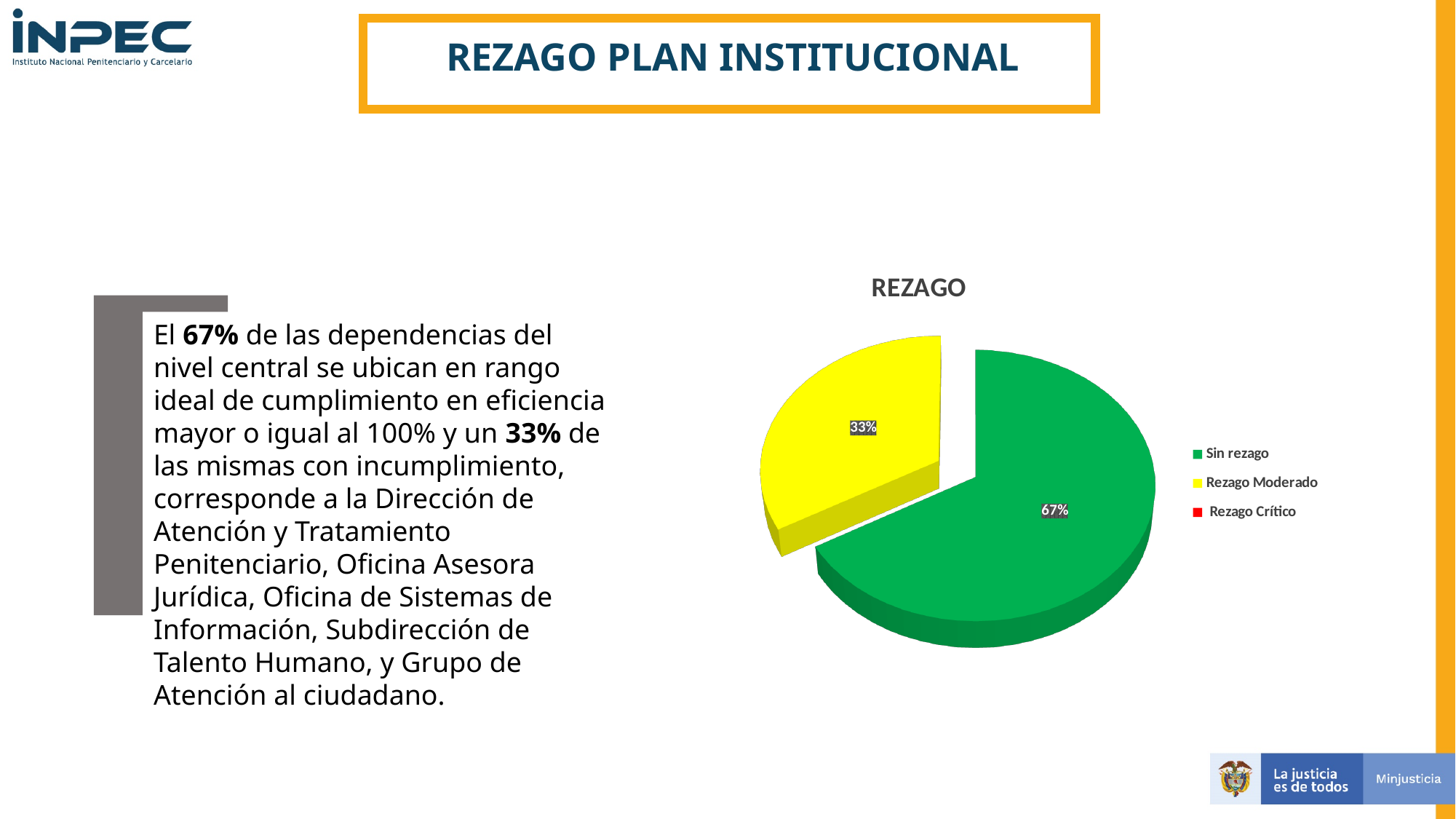
What percentage of the pie corresponds to Rezago Moderado? 33% Which category has the largest slice of the pie? Sin rezago Is the share for Rezago Moderado greater or less than 50%? less What percentage of the pie corresponds to Sin rezago? 67% What colour is the Sin rezago slice? green Is the share for Sin rezago greater or less than 50%? greater Which of the two labelled slices is larger, Sin rezago or Rezago Moderado? Sin rezago What kind of chart is shown on the slide? pie chart Which legend entry is shown in yellow? Rezago Moderado How many entries does the chart legend list? 3 What is the difference in percentage points between the Sin rezago slice and the Rezago Moderado slice? 34 What is the title of the chart? REZAGO